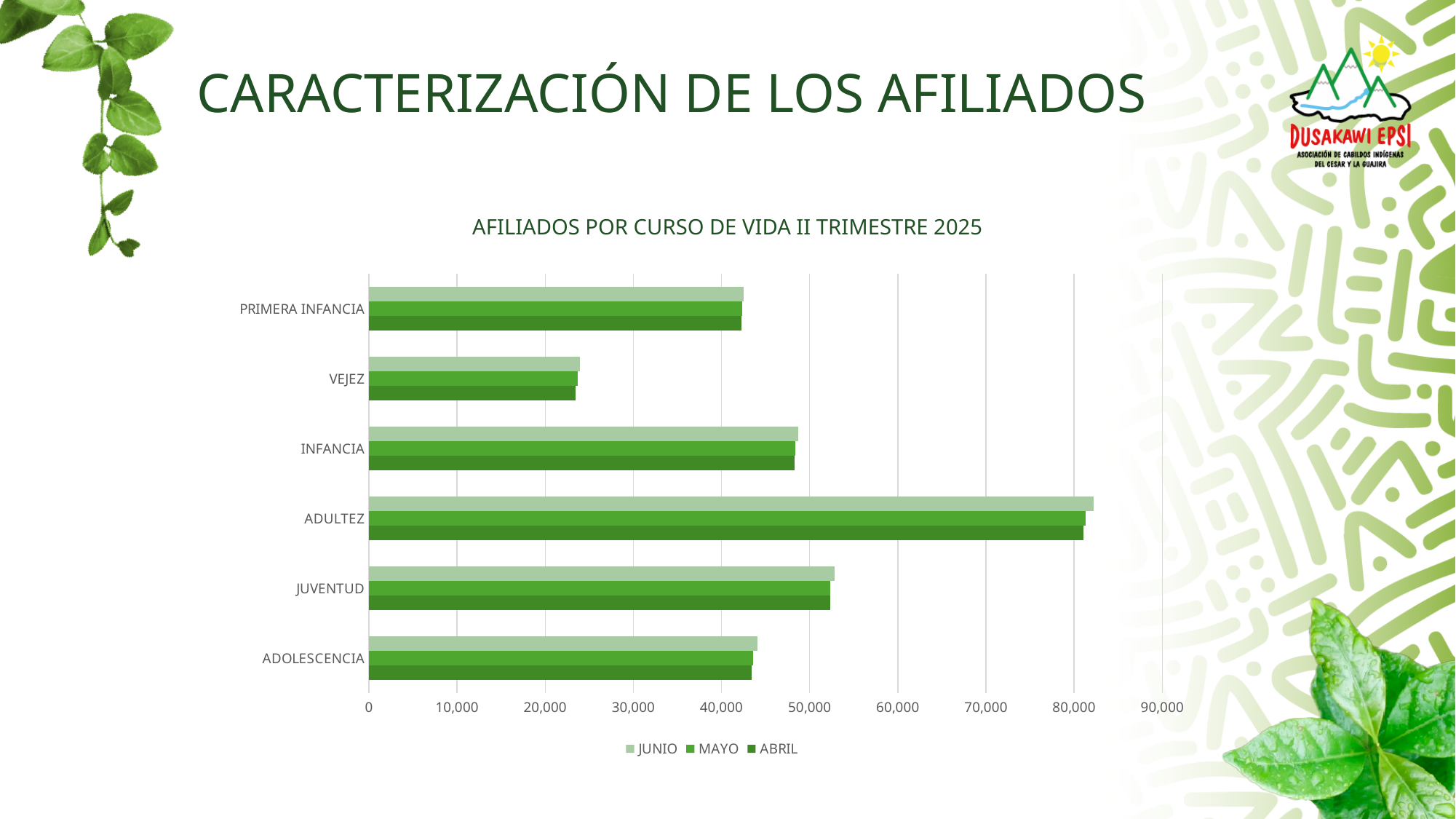
What kind of chart is shown on the slide? Bar chart Which category has the lowest number of affiliates? VEJEZ Is the JUNIO value for JUVENTUD greater or less than 50,000? greater Is the MAYO value for INFANCIA greater or less than 50,000? less Is the JUNIO value for ADULTEZ greater or less than 70,000? greater What is the title of the chart? AFILIADOS POR CURSO DE VIDA II TRIMESTRE 2025 Which category has the highest number of affiliates? ADULTEZ How many life-course categories are shown on the chart? 6 Which series is shown in the lightest green in the legend? JUNIO How many series does the legend list? 3 Which has more affiliates in JUNIO, JUVENTUD or INFANCIA? JUVENTUD